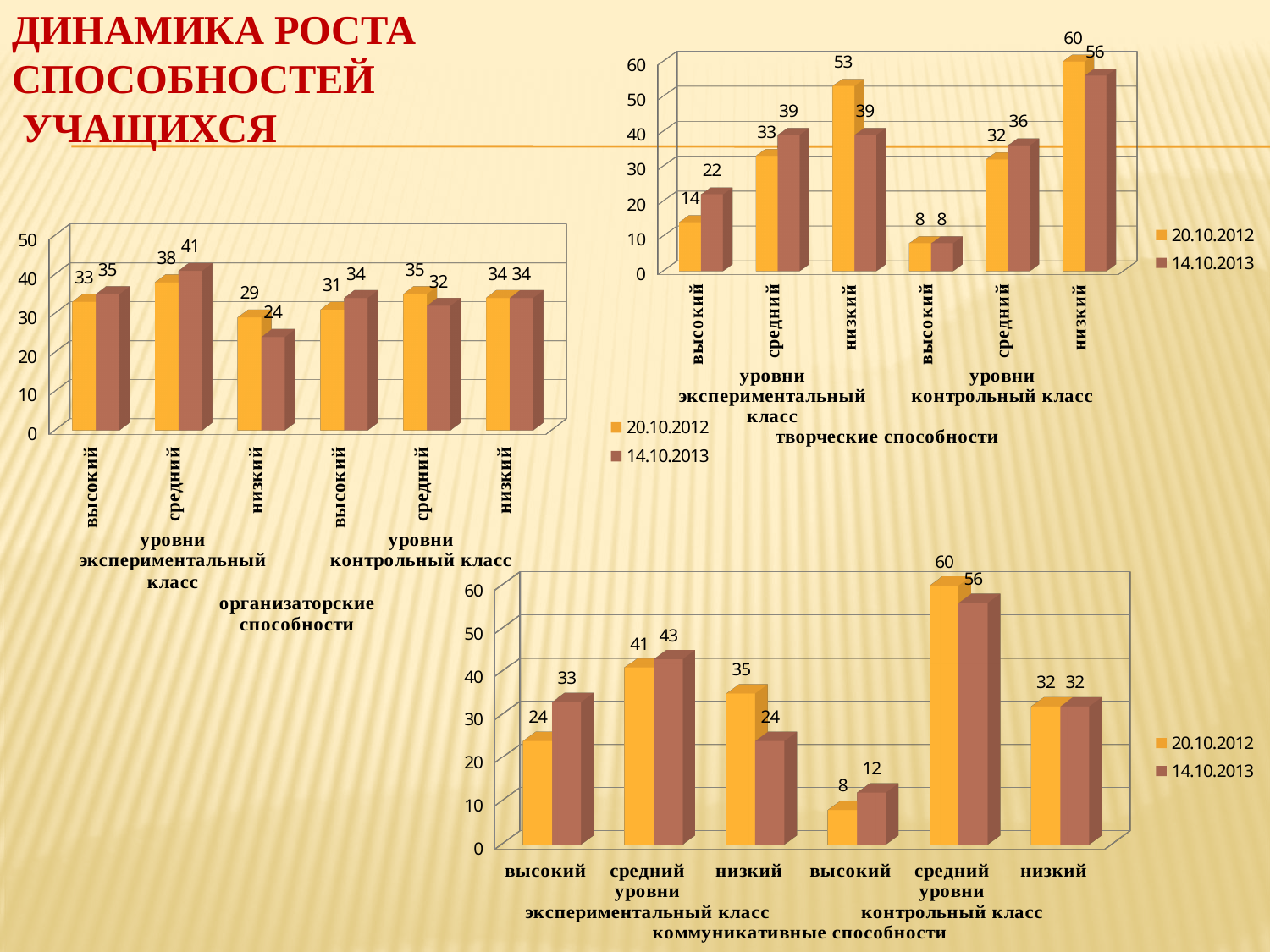
In the 'организаторские способности' chart, what is the value for 'низкий' in the экспериментальный класс for 14.10.2013? 24 In the 'коммуникативные способности' chart, what is the value for 'высокий' in the экспериментальный класс for 14.10.2013? 33 What type of chart is the 'коммуникативные способности' chart? bar chart In the 'организаторские способности' chart, what is the difference between the 14.10.2013 and 20.10.2012 values for 'высокий' in the контрольный класс? 3 In the 'творческие способности' chart, which category has the highest value for 20.10.2012? низкий (контрольный класс) In the 'творческие способности' chart, how many series does the legend list? 2 In the 'организаторские способности' chart, what is the value for 'средний' in the экспериментальный класс for 20.10.2012? 38 In the 'творческие способности' chart, what is the value for 'низкий' in the экспериментальный класс for 20.10.2012? 53 In the 'коммуникативные способности' chart, which category has the lowest value for 20.10.2012? высокий (контрольный класс) In the 'коммуникативные способности' chart, which is larger for 'низкий' in the экспериментальный класс: the 20.10.2012 value or the 14.10.2013 value? 20.10.2012 In the 'творческие способности' chart, what is the value for 'высокий' in the контрольный класс for 14.10.2013? 8 In the 'коммуникативные способности' chart, what is the difference between the 20.10.2012 and 14.10.2013 values for 'средний' in the контрольный класс? 4